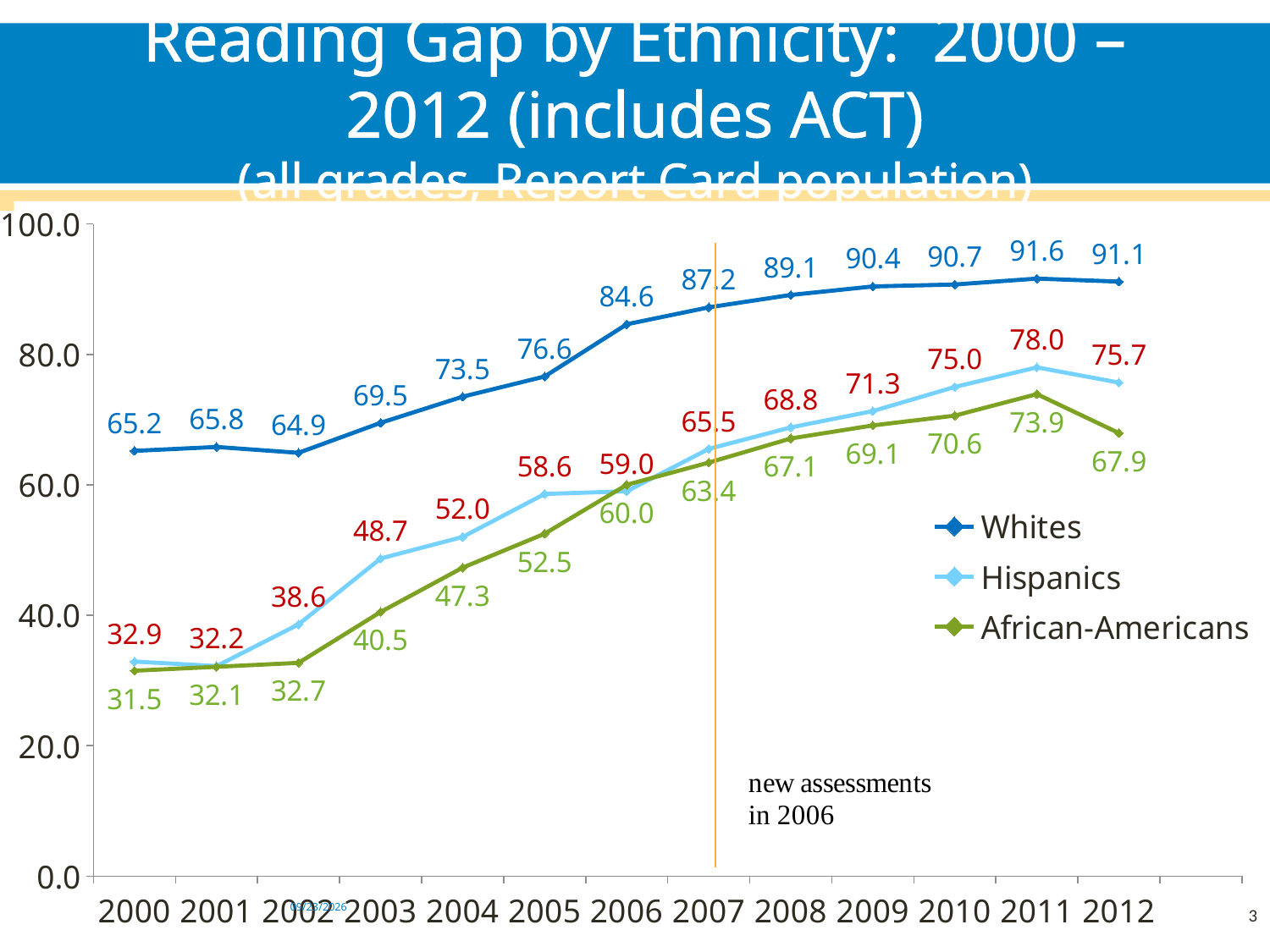
What is the value for African-Americans in 2011? 73.9 In which year is the value for Whites highest? 2011 Which is larger in 2006, the value for Hispanics or the value for African-Americans? African-Americans In which year is the value for African-Americans lowest? 2000 What event does the vertical orange line on the chart mark? New assessments in 2006 How many series does the legend list? 3 What is the value for Whites in 2006? 84.6 What is the value for Hispanics in 2003? 48.7 What is the difference between the Whites value and the African-Americans value in 2012? 23.2 How many years are plotted along the x axis? 13 What type of chart is shown on the slide? Line chart Does the value for Whites generally rise or fall from 2000 to 2012? Rise